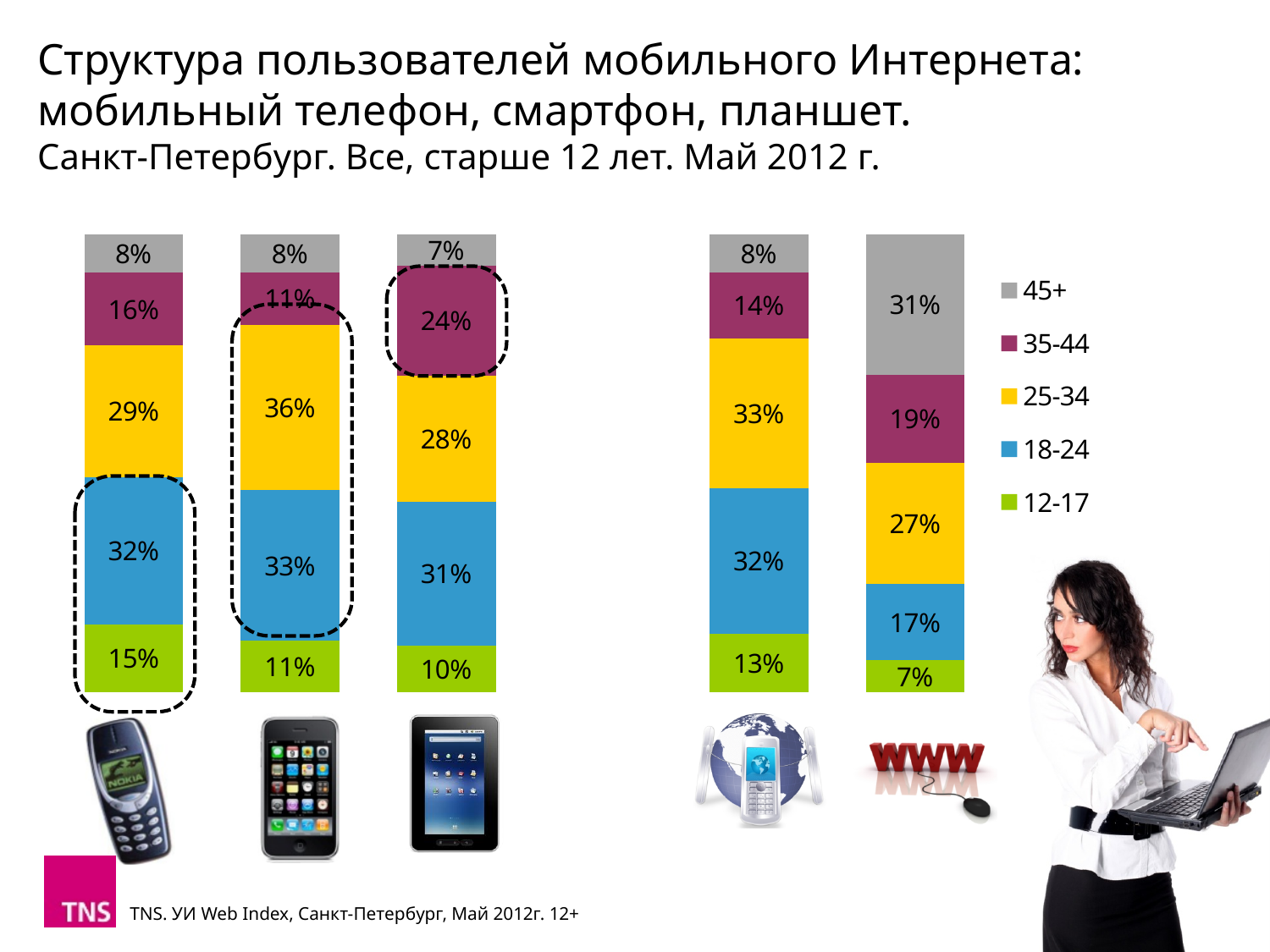
In the left chart, what is the share of the 25-34 age group in the middle bar (above the smartphone image)? 36% In the right chart, what is the difference between the 25-34 share in the left bar and in the right bar? 6 percentage points In the left chart, which age group has the largest share in the leftmost bar? 18-24 In the right chart, is the 18-24 share larger in the left bar or in the right bar? Left bar In the right chart, which age group has the smallest share in the rightmost bar? 12-17 Which colour represents the 25-34 age group in the legend? Yellow How many age groups does the legend list? 5 In the left chart, what is the share of the 12-17 age group in the leftmost bar (above the Nokia phone image)? 15% How many bars are in the left chart? 3 What kind of chart is used on this slide? Stacked bar chart In the left chart, what is the difference between the 35-44 share in the rightmost bar (24%) and in the leftmost bar (16%)? 8 percentage points In the right chart, what is the share of the 45+ age group in the rightmost bar (above the 'www' image)? 31%